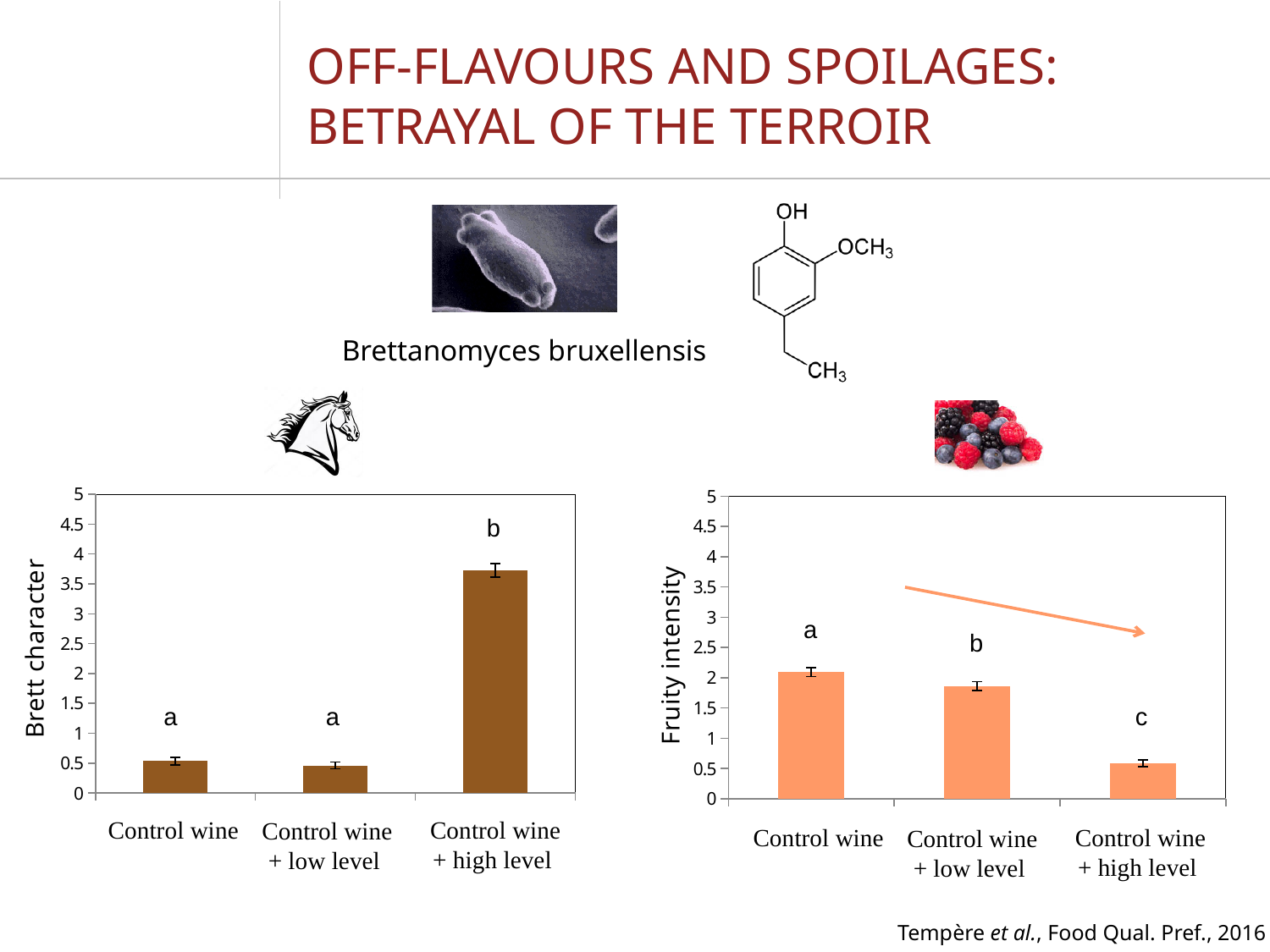
In the Brett character chart on the left, which category has the highest value? Control wine + high level In the Fruity intensity chart on the right, which category has the highest value? Control wine What is the y-axis label of the chart on the left? Brett character How many categories are shown on the x axis of the Fruity intensity chart on the right? 3 In the Fruity intensity chart on the right, do the values rise or fall from Control wine to Control wine + high level? fall What kind of chart is the Brett character chart on the left? bar chart In the Brett character chart on the left, is the value for Control wine greater or less than 1? less In the Fruity intensity chart on the right, which category has the lowest value? Control wine + high level In the Brett character chart on the left, is the value for Control wine + high level greater or less than 3? greater In the Fruity intensity chart on the right, which is larger: the value for Control wine or for Control wine + high level? Control wine In the Fruity intensity chart on the right, is the value for Control wine + high level greater or less than 1? less